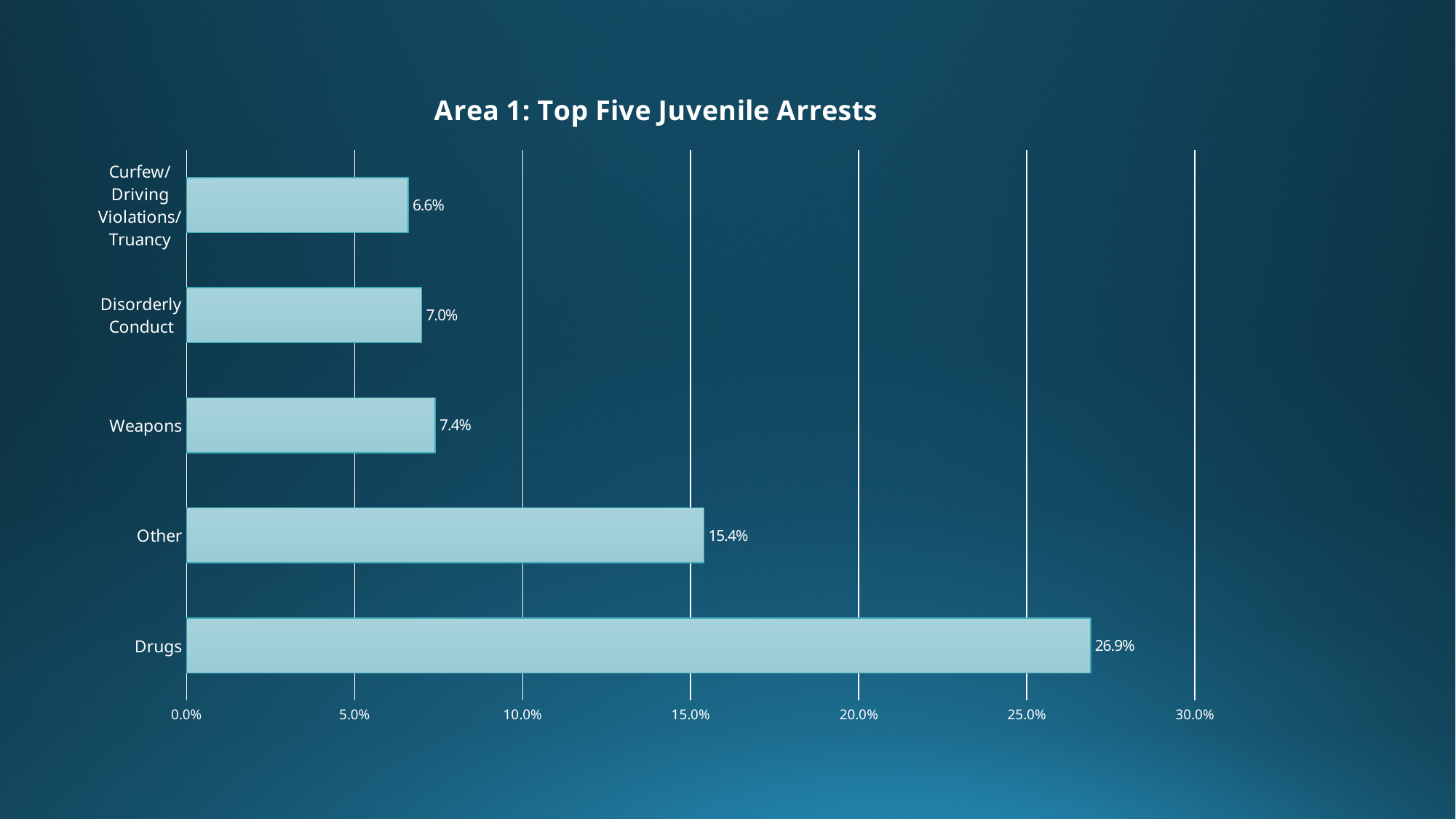
What is the value for Drugs? 26.9% Which category has the highest value? Drugs What is the value for Other? 15.4% What is the value for Curfew/Driving Violations/Truancy? 6.6% Which is larger, the value for Other or the value for Weapons? Other Is the value for Drugs greater or less than 25.0%? greater What is the value for Disorderly Conduct? 7.0% How many categories are shown in the chart? 5 What is the value for Weapons? 7.4% Which category has the lowest value? Curfew/Driving Violations/Truancy What kind of chart is shown on the slide? Bar chart What is the difference between the values for Drugs and Other? 11.5%